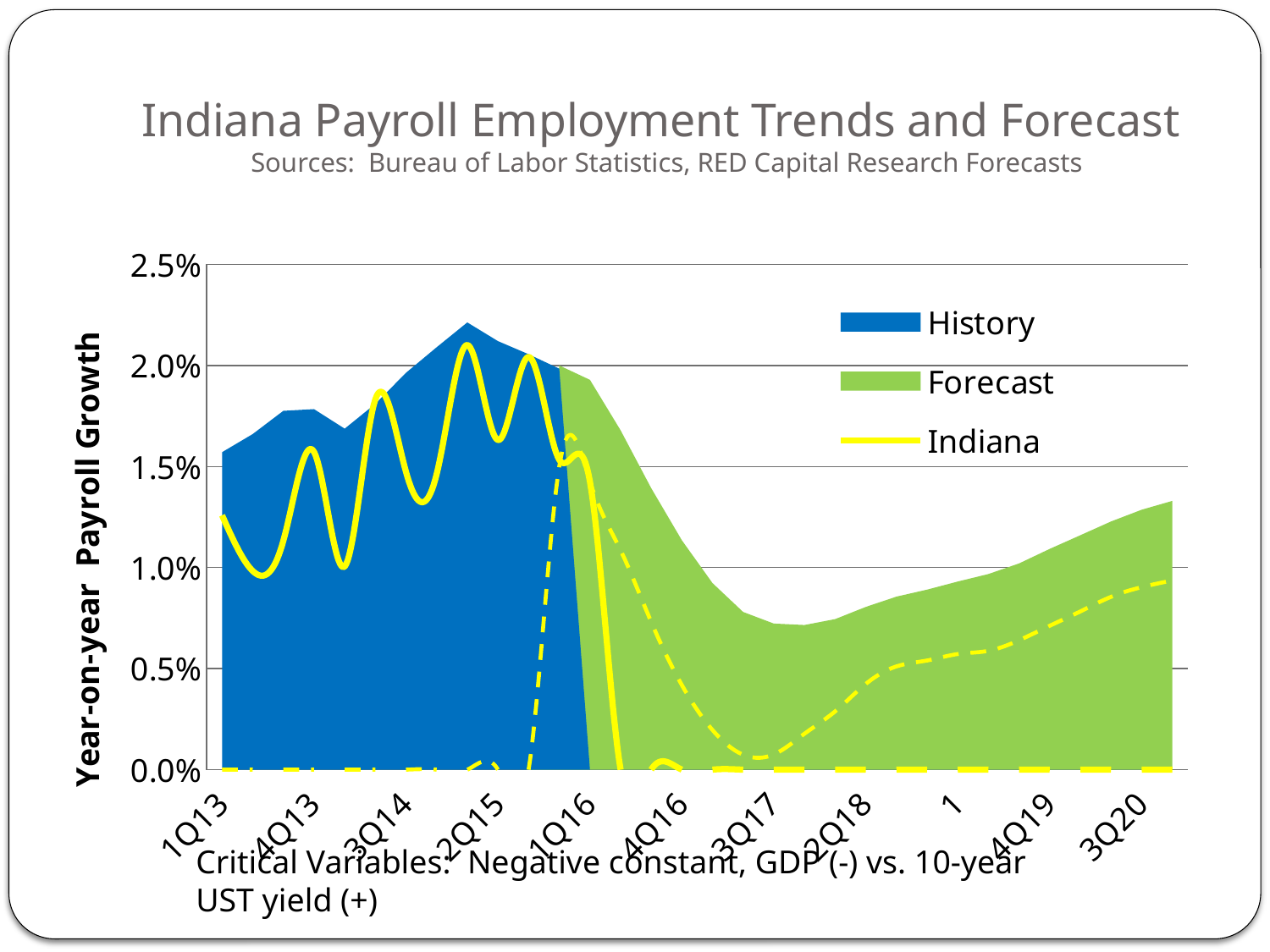
What kind of chart is shown on the slide? Area chart with a line How many series does the legend list? 3 Which is larger, the Forecast value at 3Q17 or the Forecast value at 3Q20? 3Q20 Does the Forecast area rise or fall between 1Q16 and 3Q17? fall Does the Forecast area rise or fall between 3Q17 and 3Q20? rise Is the History value at 2Q15 greater or less than 2.0%? greater Is the Forecast value at 3Q20 greater or less than 1.0%? greater What is the label on the vertical axis? Year-on-year Payroll Growth Is the Forecast value at 3Q17 greater or less than 1.0%? less What is the title of the chart? Indiana Payroll Employment Trends and Forecast What is the highest value shown on the vertical axis? 2.5%